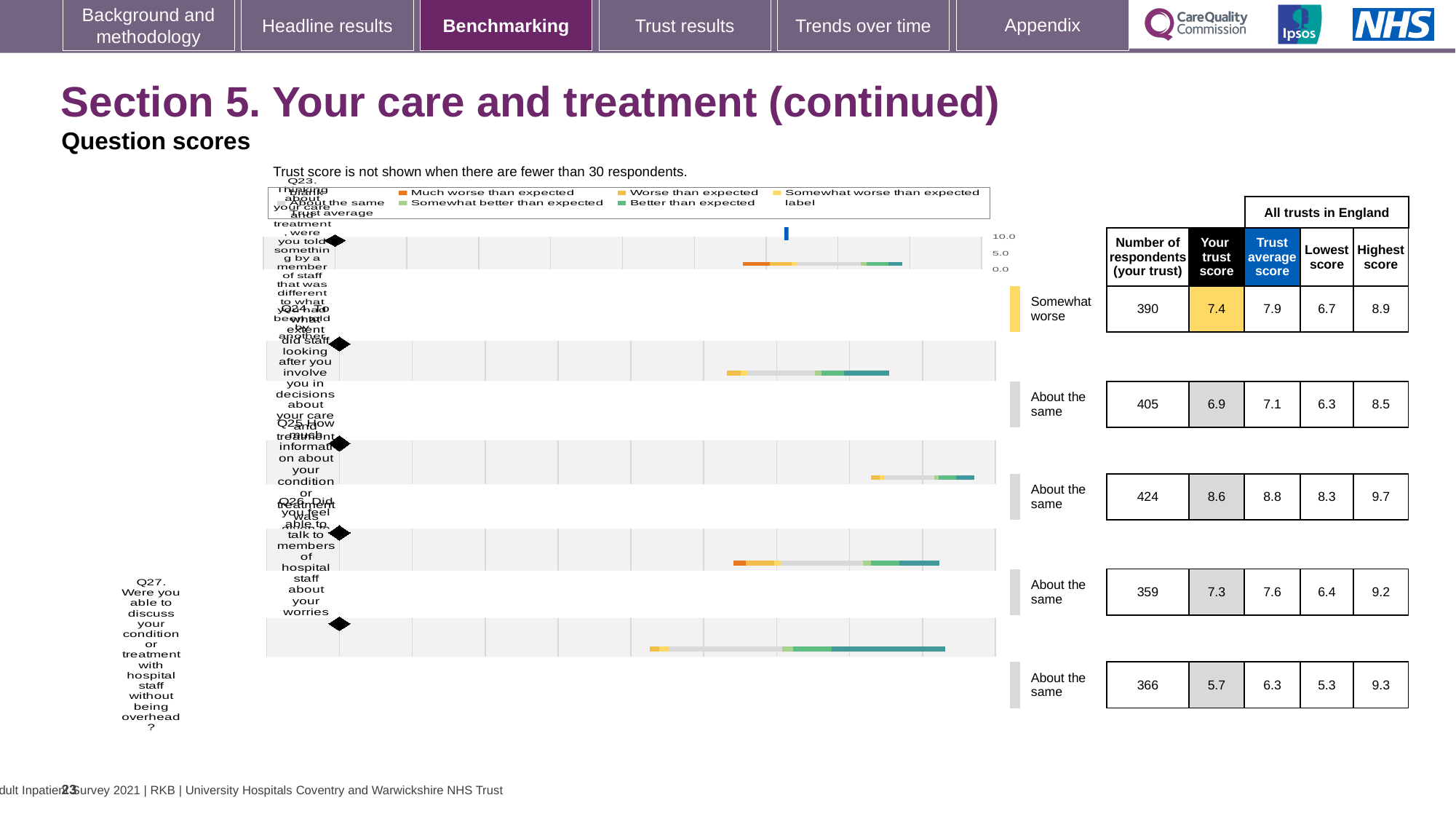
For Q24, which is larger: this trust's score or the trust average score? Trust average score How many questions are shown in the chart? 5 What is the highest score across all trusts in England for Q25? 9.7 Which question is rated 'Somewhat worse' than expected for this trust? Q23 Which question has the lowest trust score for this trust? Q27 What is the difference between the trust average score and this trust's score for Q23? 0.5 What is the lowest score across all trusts in England for Q27? 5.3 How many respondents answered Q25 (how much information about your condition or treatment was given)? 424 What is the trust average score for Q24 (did staff involve you in decisions about your care and treatment)? 7.1 Which question has the highest trust score for this trust? Q25 What is the trust score for Q27 (discussing your condition or treatment without being overheard)? 5.7 What kind of chart is used to show the question scores? Bar chart